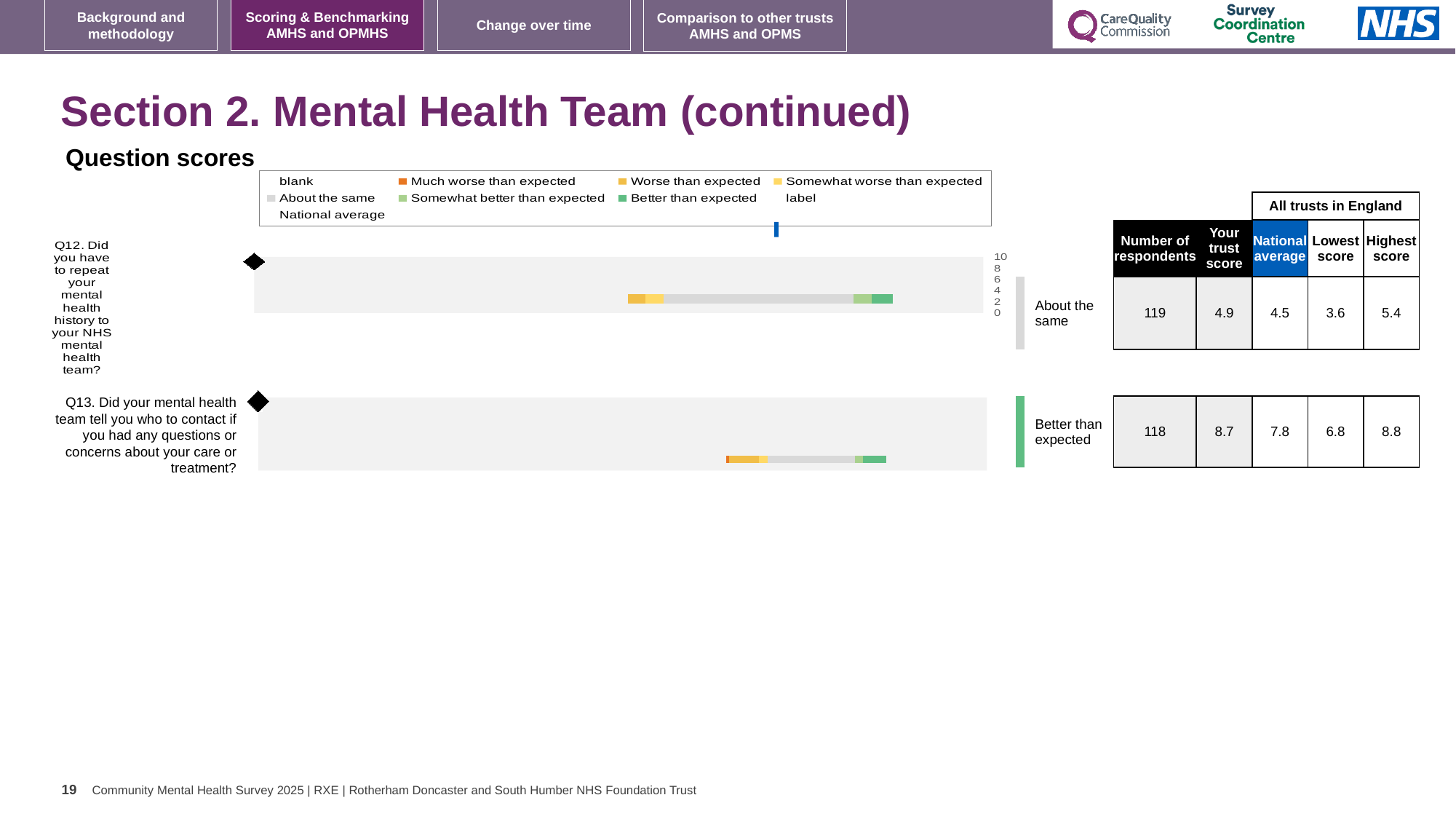
How many questions are plotted in the question scores chart? 2 Which benchmark category is Q12 assigned to in the question scores chart? About the same Which benchmark category is Q13 assigned to in the question scores chart? Better than expected What is the highest score among all trusts in England for Q13? 8.8 Which question has the higher trust score, Q12 or Q13? Q13 What kind of chart is used to show the question scores on this slide? Bar chart What is the trust score for Q12 (repeating mental health history)? 4.9 What is the national average score for Q12? 4.5 Which legend entry in the question scores chart is shown in dark green? Better than expected How many respondents answered Q13? 118 What is the trust score for Q13 (told who to contact with questions or concerns)? 8.7 What is the difference between the trust score and the national average for Q13? 0.9